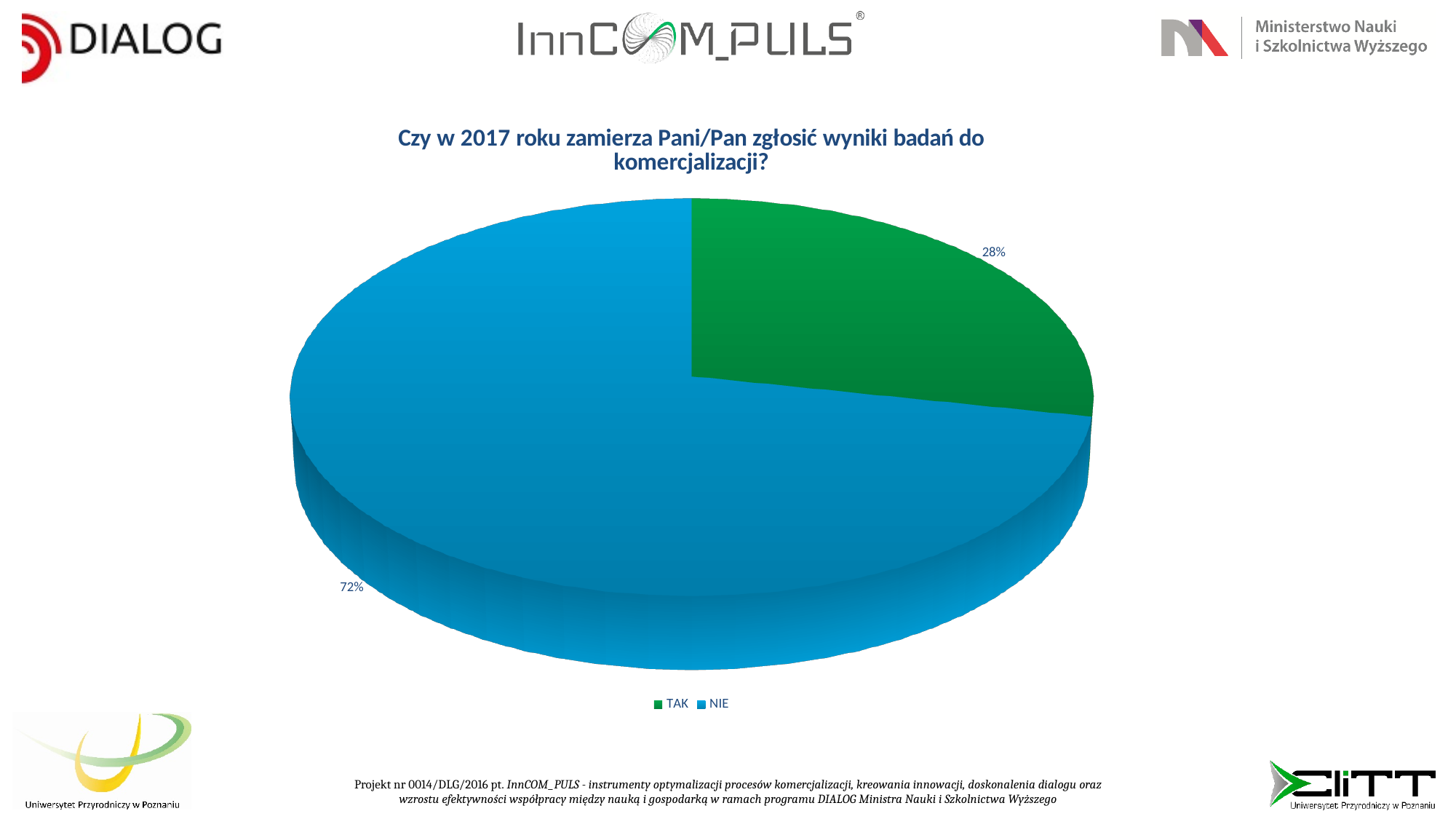
What is the title of the chart? Czy w 2017 roku zamierza Pani/Pan zgłosić wyniki badań do komercjalizacji? What is the difference in percentage points between the NIE share and the TAK share? 44 Which is larger, the share for TAK or the share for NIE? NIE What share of the pie does NIE represent? 72% What share of the pie does TAK represent? 28% What colour is the TAK slice in the pie chart? green How many slices does the pie chart have? 2 Which category has the largest slice of the pie? NIE How many entries does the legend list? 2 Which category has the smallest slice of the pie? TAK What kind of chart is shown on the slide? pie chart